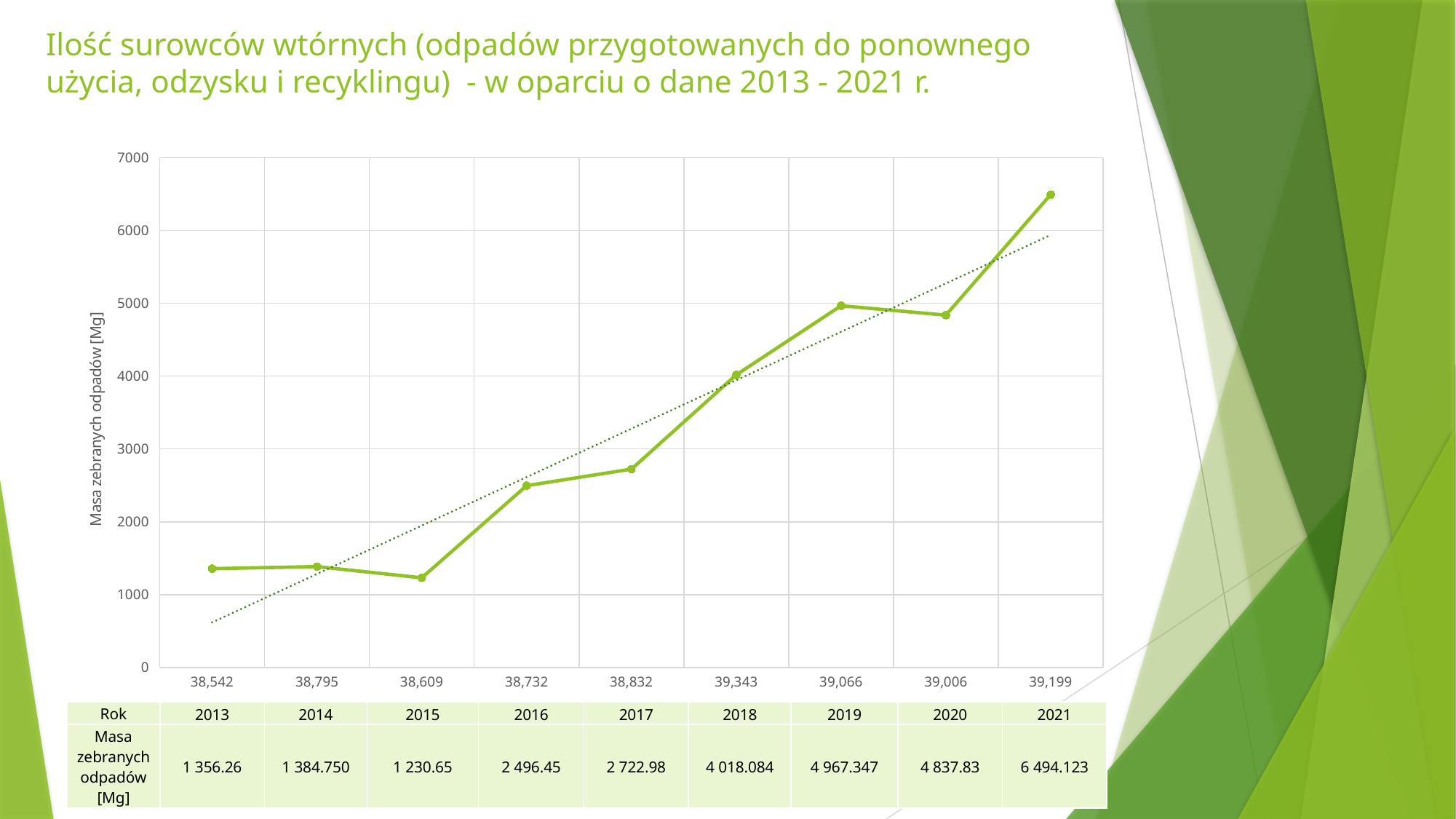
How many data points are plotted on the line? 9 Overall, do the values rise or fall from 2013 to 2021? rise According to the data table, what is the mass of collected waste [Mg] for 2018? 4 018.084 What is the label of the vertical axis? Masa zebranych odpadów [Mg] Which year has the highest mass of collected waste? 2021 Which year has the larger mass of collected waste, 2019 or 2020? 2019 What kind of chart is shown on the slide? line chart According to the data table, what is the mass of collected waste [Mg] for 2021? 6 494.123 Which year has the lowest mass of collected waste? 2015 Is the value for 2021 greater or less than 6000? greater Is the value for 2017 greater or less than 3000? less According to the data table, what is the mass of collected waste [Mg] for 2015? 1 230.65